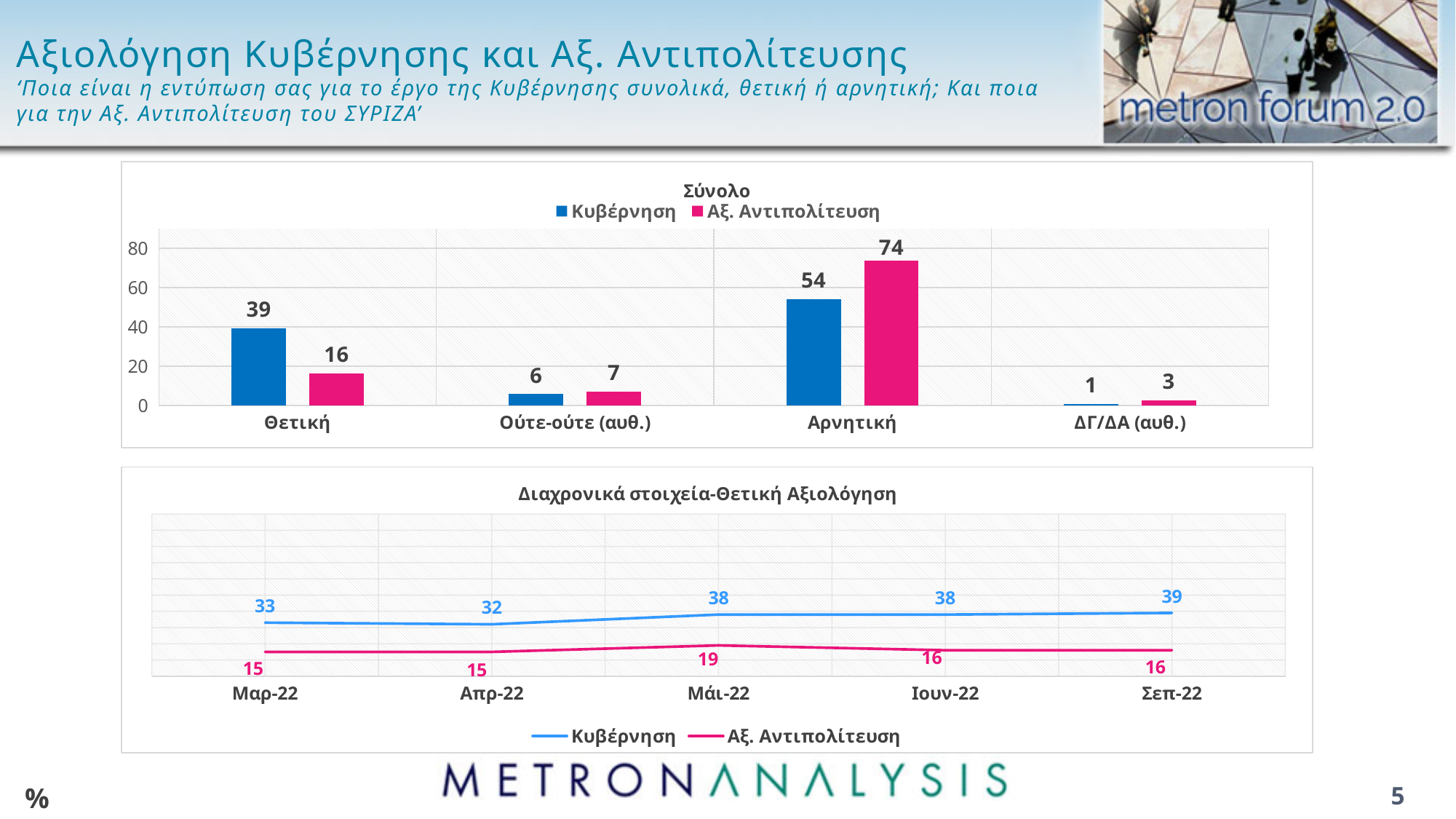
In the 'Σύνολο' bar chart, which category has the lowest value for Αξ. Αντιπολίτευση? ΔΓ/ΔΑ (αυθ.) In the 'Διαχρονικά στοιχεία-Θετική Αξιολόγηση' line chart, what is the value for Κυβέρνηση in Μάι-22? 38 In the 'Σύνολο' bar chart, what is the difference between the Αρνητική values for Αξ. Αντιπολίτευση and Κυβέρνηση? 20 In the 'Σύνολο' bar chart, which category has the highest value for Κυβέρνηση? Αρνητική How many series does the legend of the 'Διαχρονικά στοιχεία-Θετική Αξιολόγηση' line chart list? 2 In the 'Διαχρονικά στοιχεία-Θετική Αξιολόγηση' line chart, what is the value for Αξ. Αντιπολίτευση in Σεπ-22? 16 In the 'Σύνολο' bar chart, how many categories are shown on the x axis? 4 What kind of chart is the 'Σύνολο' chart? Bar chart In the 'Σύνολο' bar chart, what is the value for Κυβέρνηση in the Θετική category? 39 In the 'Διαχρονικά στοιχεία-Θετική Αξιολόγηση' line chart, in which month does Αξ. Αντιπολίτευση reach its highest value? Μάι-22 In the 'Σύνολο' bar chart, what is the value for Αξ. Αντιπολίτευση in the Αρνητική category? 74 In the 'Σύνολο' bar chart, which series has the larger value in the Θετική category? Κυβέρνηση